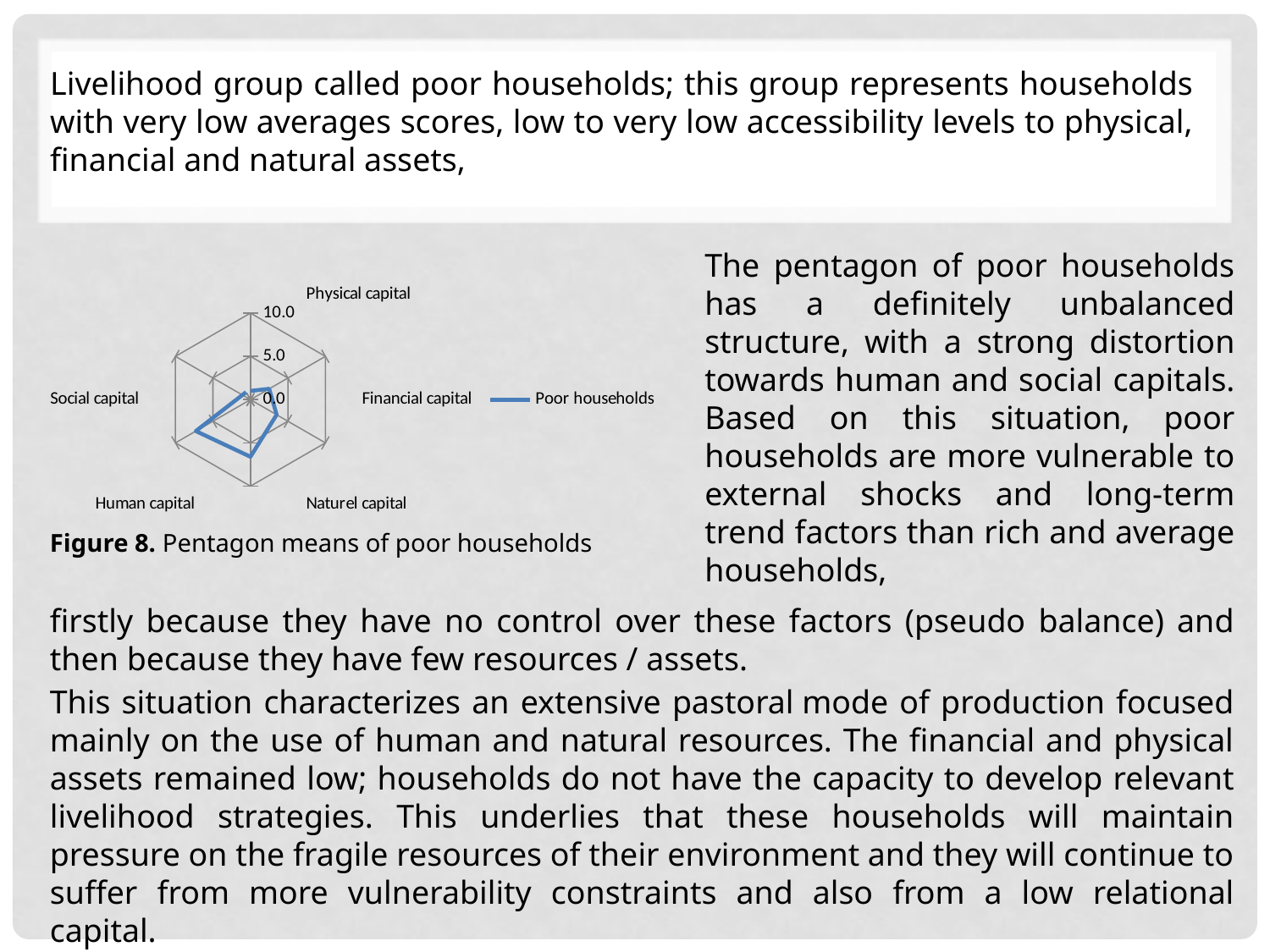
What is the name of the series shown in the chart legend? Poor households Is the value for Naturel capital greater or less than 5.0? less Is the value for Financial capital greater or less than 5.0? less Is the value for Physical capital greater or less than 5.0? less How many capital categories (axes) does the pentagon chart have? 5 What is the highest value shown on the chart's axis scale? 10.0 What kind of chart is shown in Figure 8? Radar chart How many series does the legend of the chart list? 1 Which is larger for poor households, Social capital or Physical capital? Social capital Which is larger for poor households, Human capital or Financial capital? Human capital